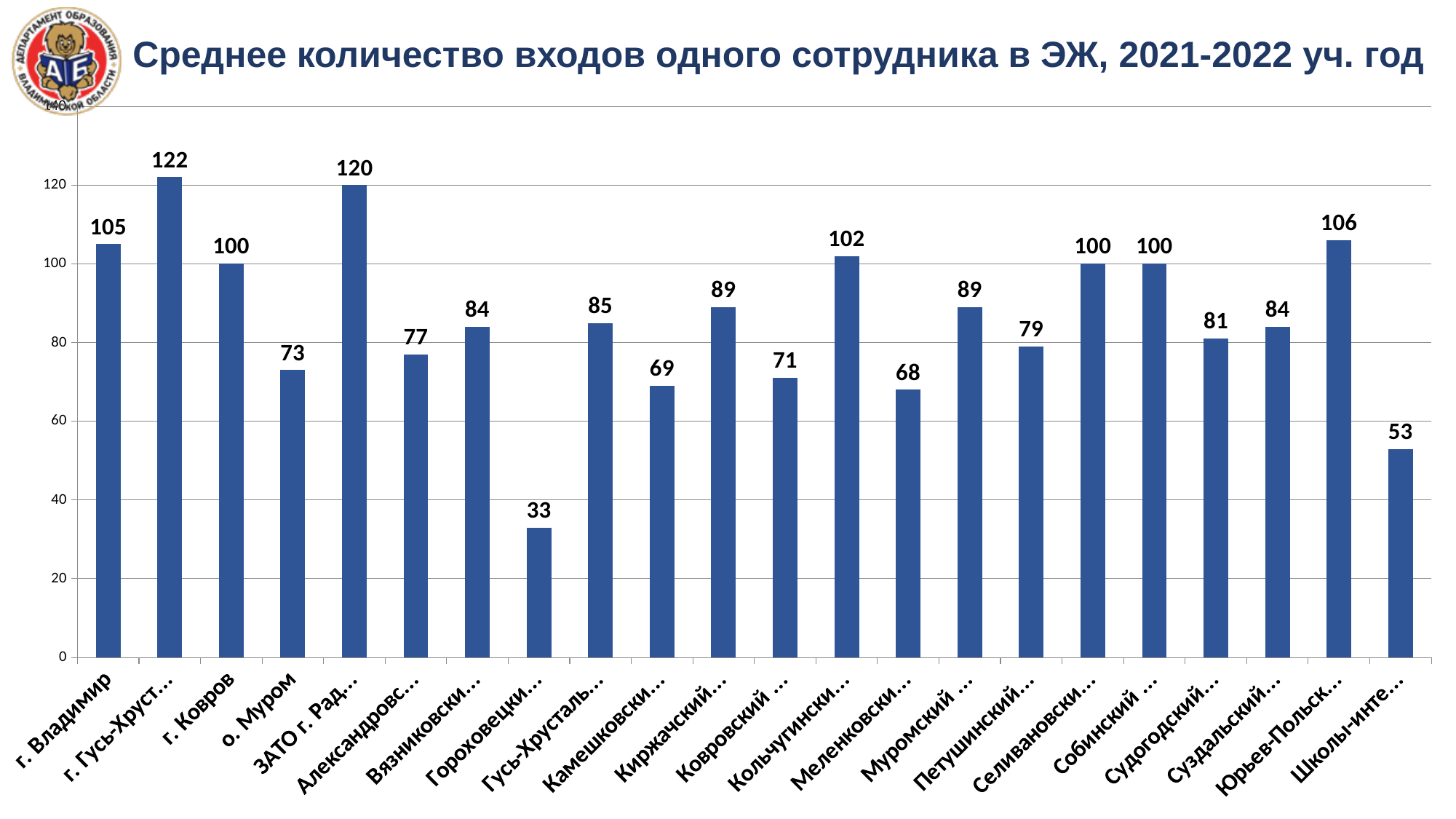
What is the title of the chart? Среднее количество входов одного сотрудника в ЭЖ, 2021-2022 уч. год What is the difference between the values for г. Владимир and о. Муром? 32 What is the value for г. Ковров? 100 What is the value for г. Владимир? 105 What is the value for о. Муром? 73 How many categories (bars) are shown in the chart? 22 What kind of chart is shown on the slide? bar chart What is the value for the category labelled 'Юрьев-Польск…'? 106 Which category has the highest value? г. Гусь-Хруст… Which category has the lowest value? Гороховецки… Which is larger, the value for г. Владимир or the value for г. Ковров? г. Владимир Is the value for the category labelled 'Школы-инте…' greater or less than 60? less